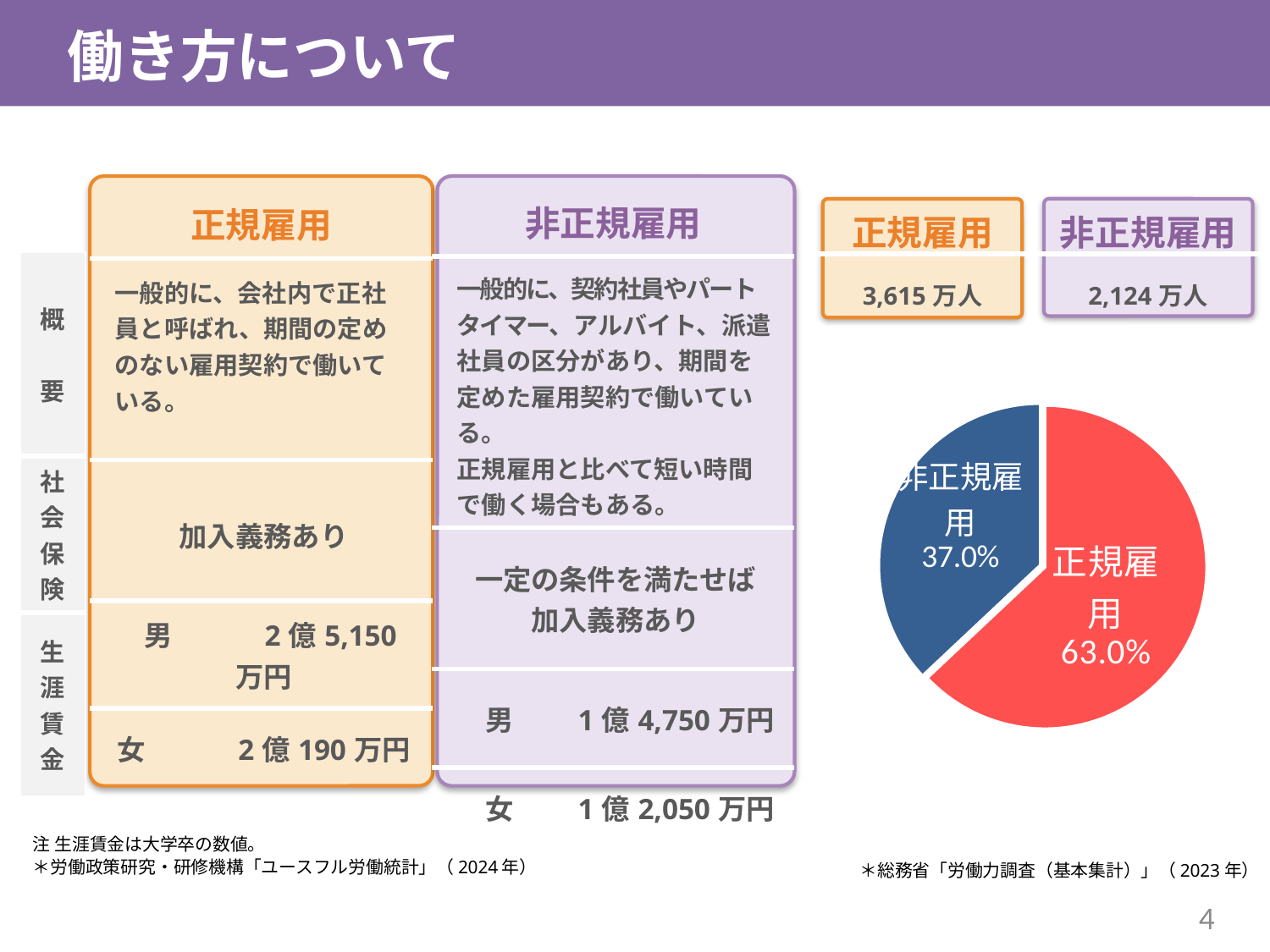
Which slice of the pie chart is the largest? 正規雇用 In the pie chart, what percentage is shown for 非正規雇用? 37.0% What share of the pie chart does the 非正規雇用 slice represent? 37.0% Which slice of the pie chart is the smallest? 非正規雇用 What kind of chart is shown on the slide? pie chart In the pie chart, which is larger: the 正規雇用 slice or the 非正規雇用 slice? 正規雇用 In the pie chart, what percentage is shown for 正規雇用? 63.0% What colour is the 正規雇用 slice in the pie chart? red Is the 正規雇用 slice of the pie chart greater or less than 50%? greater What colour is the 非正規雇用 slice in the pie chart? blue How many slices does the pie chart have? 2 What is the difference in percentage points between the 正規雇用 slice and the 非正規雇用 slice in the pie chart? 26.0 percentage points